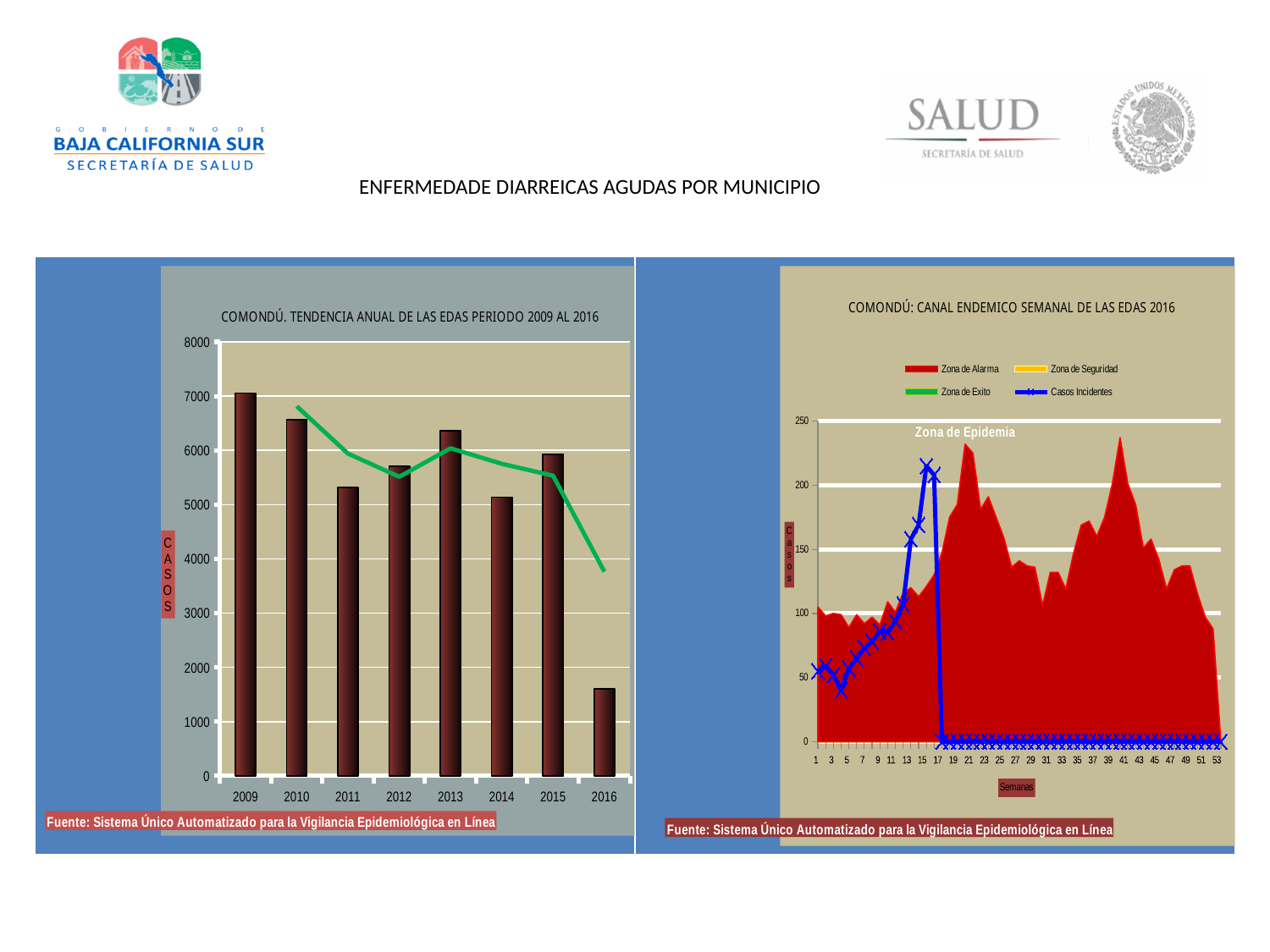
How many years are shown on the x axis of the left chart (COMONDÚ. TENDENCIA ANUAL DE LAS EDAS PERIODO 2009 AL 2016)? 8 In the right chart (COMONDÚ: CANAL ENDEMICO SEMANAL DE LAS EDAS 2016), is the peak value of Casos Incidentes greater or less than 200? greater In the left chart (COMONDÚ. TENDENCIA ANUAL DE LAS EDAS PERIODO 2009 AL 2016), is the value for 2016 greater or less than 2000? less In the left chart (COMONDÚ. TENDENCIA ANUAL DE LAS EDAS PERIODO 2009 AL 2016), is the value for 2014 greater or less than 6000? less In the right chart (COMONDÚ: CANAL ENDEMICO SEMANAL DE LAS EDAS 2016), what is the label of the x axis? Semanas How many series does the legend of the right chart (COMONDÚ: CANAL ENDEMICO SEMANAL DE LAS EDAS 2016) list? 4 In the left chart (COMONDÚ. TENDENCIA ANUAL DE LAS EDAS PERIODO 2009 AL 2016), which bar is taller, 2010 or 2011? 2010 In the left chart (COMONDÚ. TENDENCIA ANUAL DE LAS EDAS PERIODO 2009 AL 2016), which bar is taller, 2013 or 2014? 2013 What kind of chart is the left chart (COMONDÚ. TENDENCIA ANUAL DE LAS EDAS PERIODO 2009 AL 2016)? Bar chart with a line In the left chart (COMONDÚ. TENDENCIA ANUAL DE LAS EDAS PERIODO 2009 AL 2016), which year has the lowest bar? 2016 In the left chart (COMONDÚ. TENDENCIA ANUAL DE LAS EDAS PERIODO 2009 AL 2016), which year has the highest bar? 2009